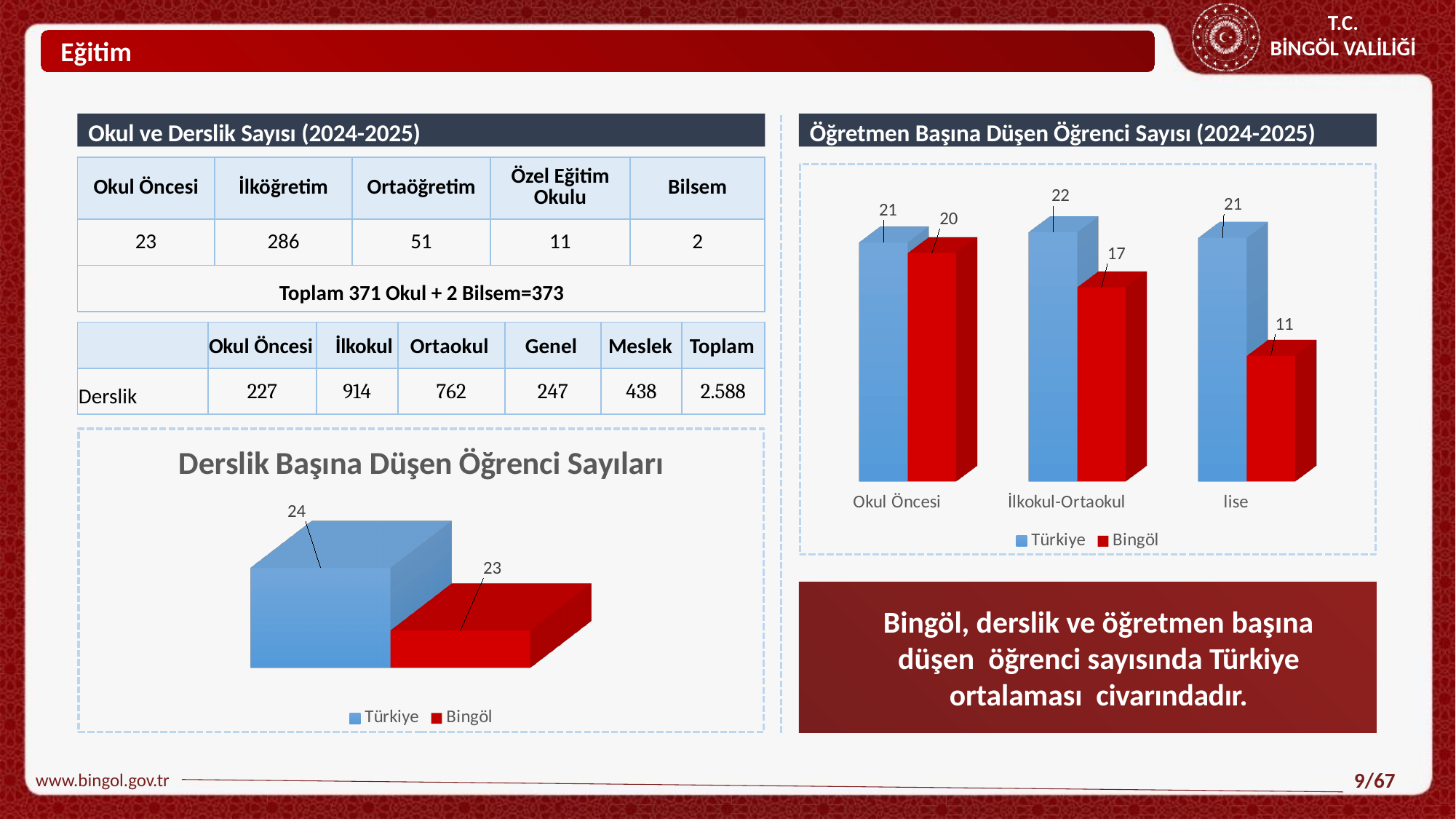
In the chart titled "Öğretmen Başına Düşen Öğrenci Sayısı (2024-2025)", what is the Türkiye value for İlkokul-Ortaokul? 22 In the chart titled "Derslik Başına Düşen Öğrenci Sayıları", what is the value for Bingöl? 23 In the chart titled "Öğretmen Başına Düşen Öğrenci Sayısı (2024-2025)", what is the Bingöl value for Okul Öncesi? 20 In the chart titled "Öğretmen Başına Düşen Öğrenci Sayısı (2024-2025)", how many categories are shown on the x axis? 3 In the chart titled "Derslik Başına Düşen Öğrenci Sayıları", how many series does the legend list? 2 In the chart titled "Derslik Başına Düşen Öğrenci Sayıları", what is the difference between the Türkiye and Bingöl values? 1 In the chart titled "Öğretmen Başına Düşen Öğrenci Sayısı (2024-2025)", which category has the highest Türkiye value? İlkokul-Ortaokul What kind of chart is the one titled "Öğretmen Başına Düşen Öğrenci Sayısı (2024-2025)"? Bar chart In the chart titled "Öğretmen Başına Düşen Öğrenci Sayısı (2024-2025)", which category has the lowest Bingöl value? lise In the chart titled "Öğretmen Başına Düşen Öğrenci Sayısı (2024-2025)", what is the Bingöl value for lise? 11 In the chart titled "Öğretmen Başına Düşen Öğrenci Sayısı (2024-2025)", what is the difference between the Türkiye and Bingöl values for lise? 10 In the chart titled "Derslik Başına Düşen Öğrenci Sayıları", what is the value for Türkiye? 24